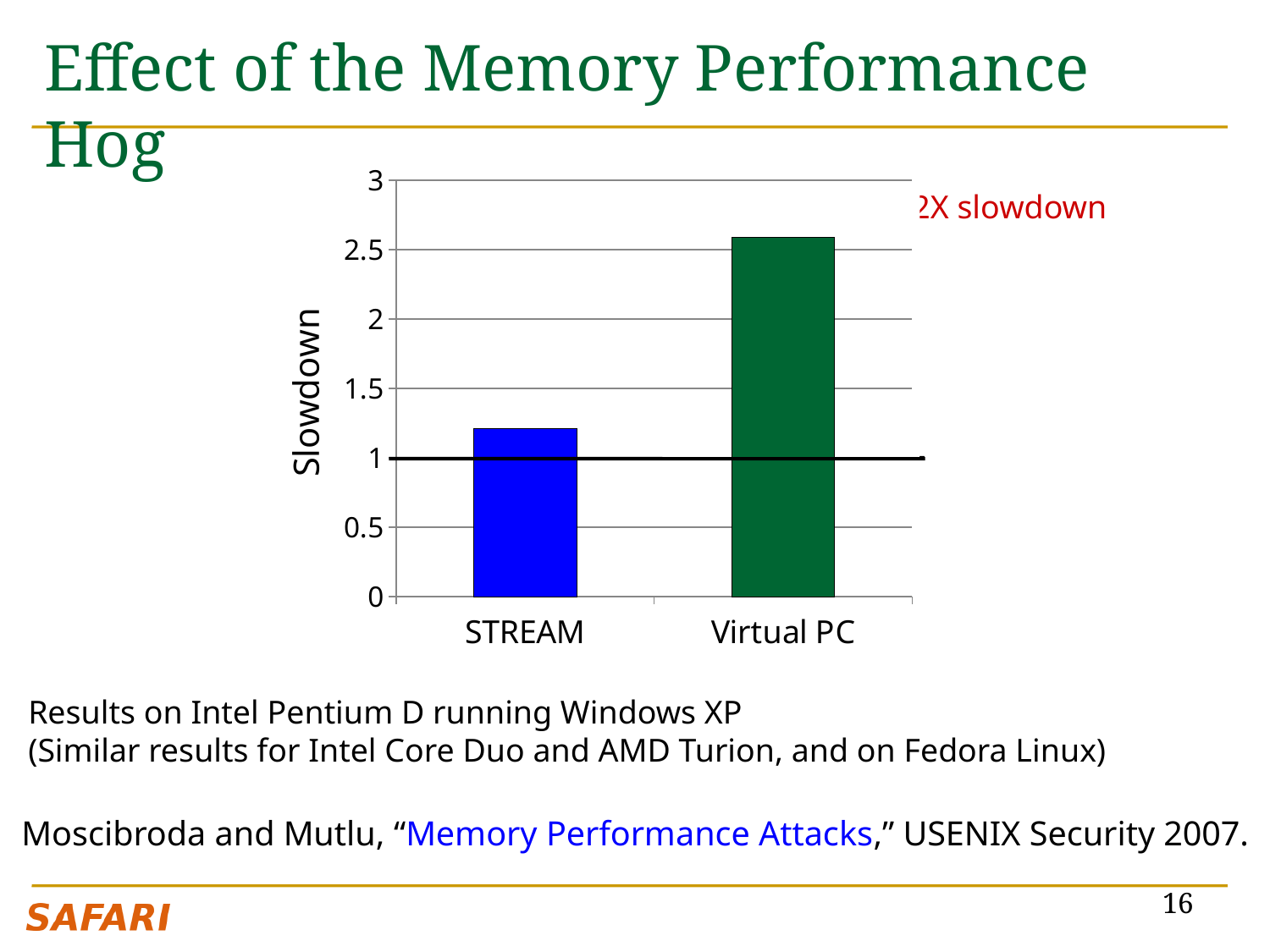
Which category has the lowest slowdown? STREAM How many categories are plotted on the x axis? 2 What kind of chart is shown on the slide? bar chart What colour is the bar for Virtual PC? green Is the slowdown for Virtual PC greater or less than 3? less Which has a larger slowdown, STREAM or Virtual PC? Virtual PC Is the slowdown for STREAM greater or less than 1? greater What is the label of the y axis? Slowdown Is the slowdown for STREAM greater or less than 1.5? less Which category has the highest slowdown? Virtual PC